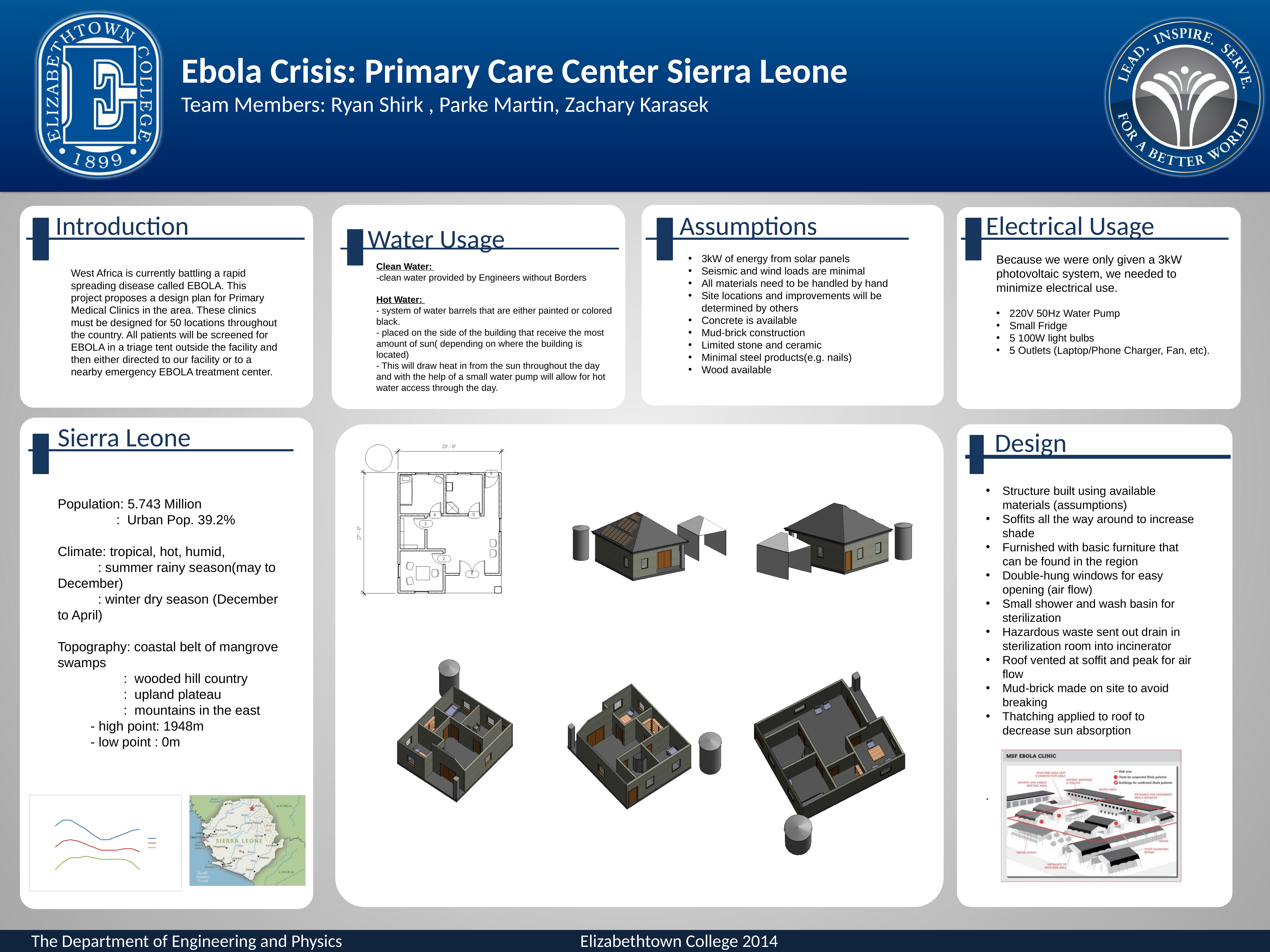
How many lines (series) are plotted on the chart in the Sierra Leone panel? 3 On the chart in the Sierra Leone panel, which coloured line is plotted highest? the blue line On the chart in the Sierra Leone panel, is the red line above or below the green line? above What kind of chart is shown in the bottom-left of the Sierra Leone panel? line chart On the chart in the Sierra Leone panel, which coloured line is plotted lowest? the green line How many entries does the legend of the chart in the Sierra Leone panel list? 3 What colours are the three lines on the chart in the Sierra Leone panel? blue, red and green